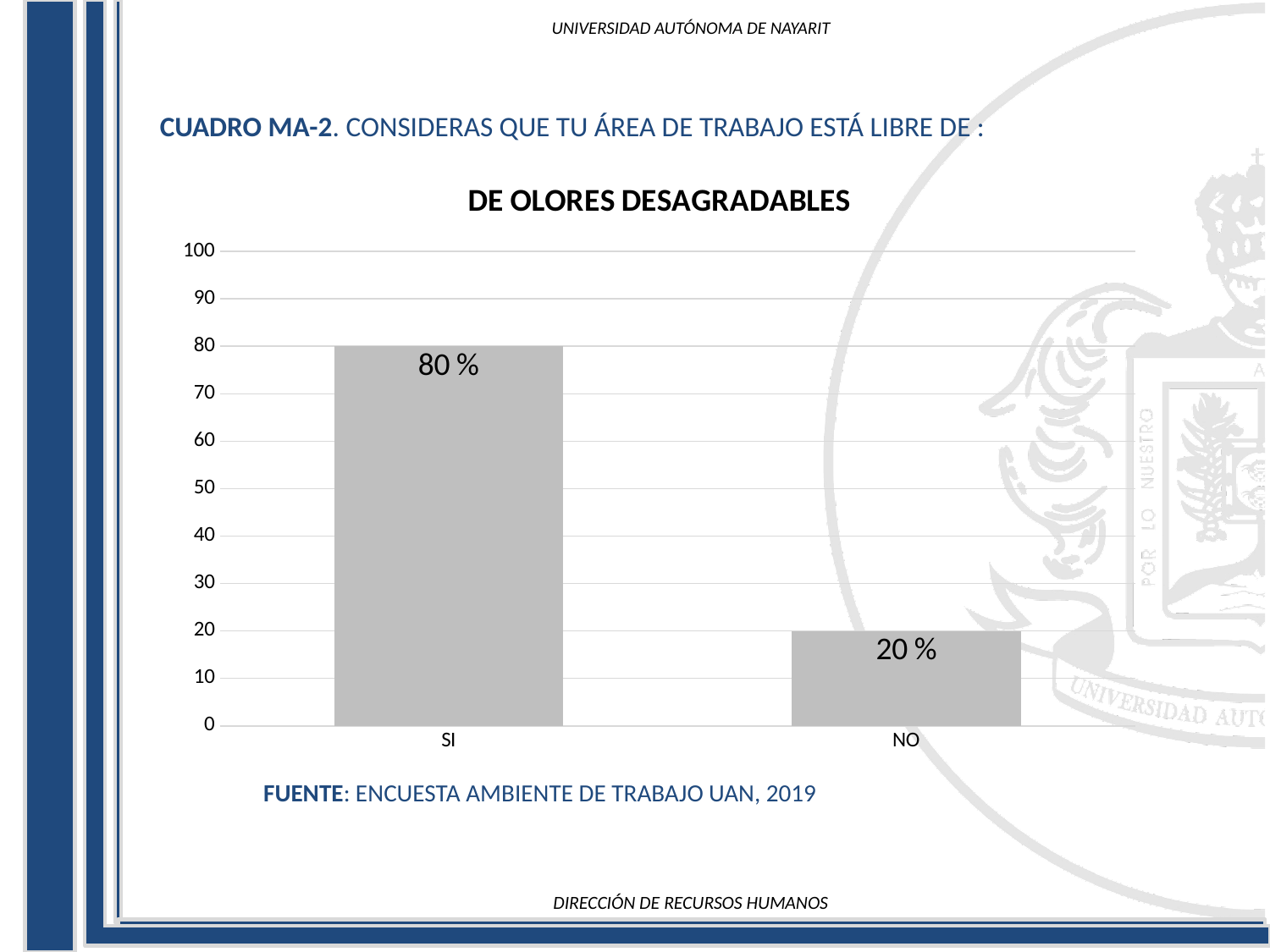
Is the value for SI greater or less than 70? greater Is the value for NO greater or less than 50? less What is the value for SI? 80 % Which category has the lowest value? NO What is the maximum value shown on the y axis? 100 What is the difference between the values for SI and NO? 60 % Which is larger, the value for SI or the value for NO? SI What kind of chart is shown on the slide? bar chart How many categories are shown on the x axis? 2 What is the value for NO? 20 % What is the title of the chart? DE OLORES DESAGRADABLES Which category has the highest value? SI